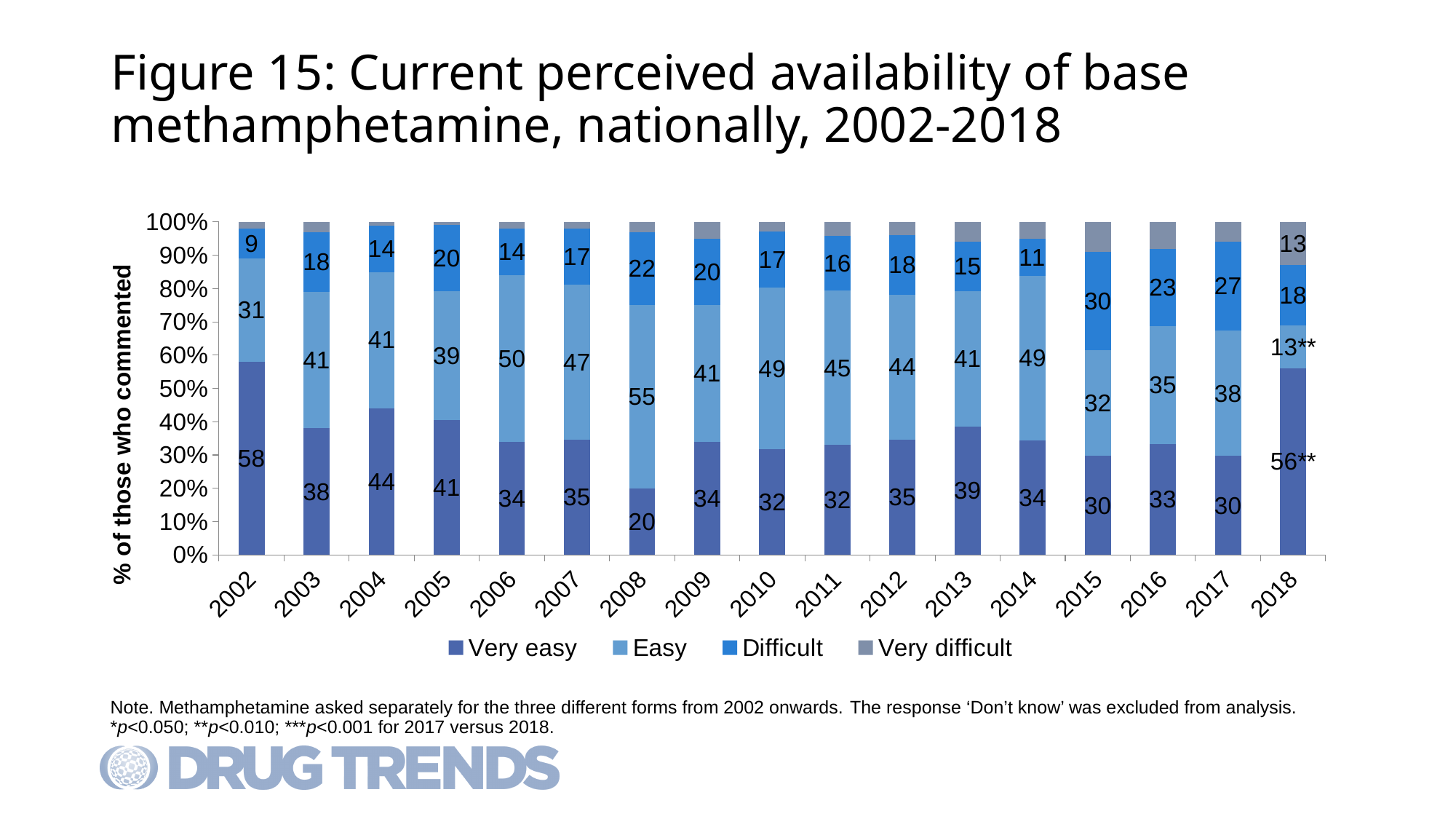
What kind of chart is shown on the slide? Stacked bar chart In which year is the 'Very easy' segment the largest? 2002 How many series does the legend list? 4 In which year is the 'Very easy' segment the smallest? 2008 What is the difference between the 'Easy' value in 2008 and the 'Easy' value in 2015? 23 In which year is the 'Difficult' segment the smallest? 2002 What is the 'Easy' value for 2008? 55 What is the 'Very difficult' value shown for 2018? 13 What is the 'Difficult' value for 2015? 30 Which is larger: the 'Very easy' value in 2013 or the 'Very easy' value in 2014? 2013 What percentage of respondents rated base methamphetamine as 'Very easy' to obtain in 2002? 58 How many years are shown on the x axis? 17